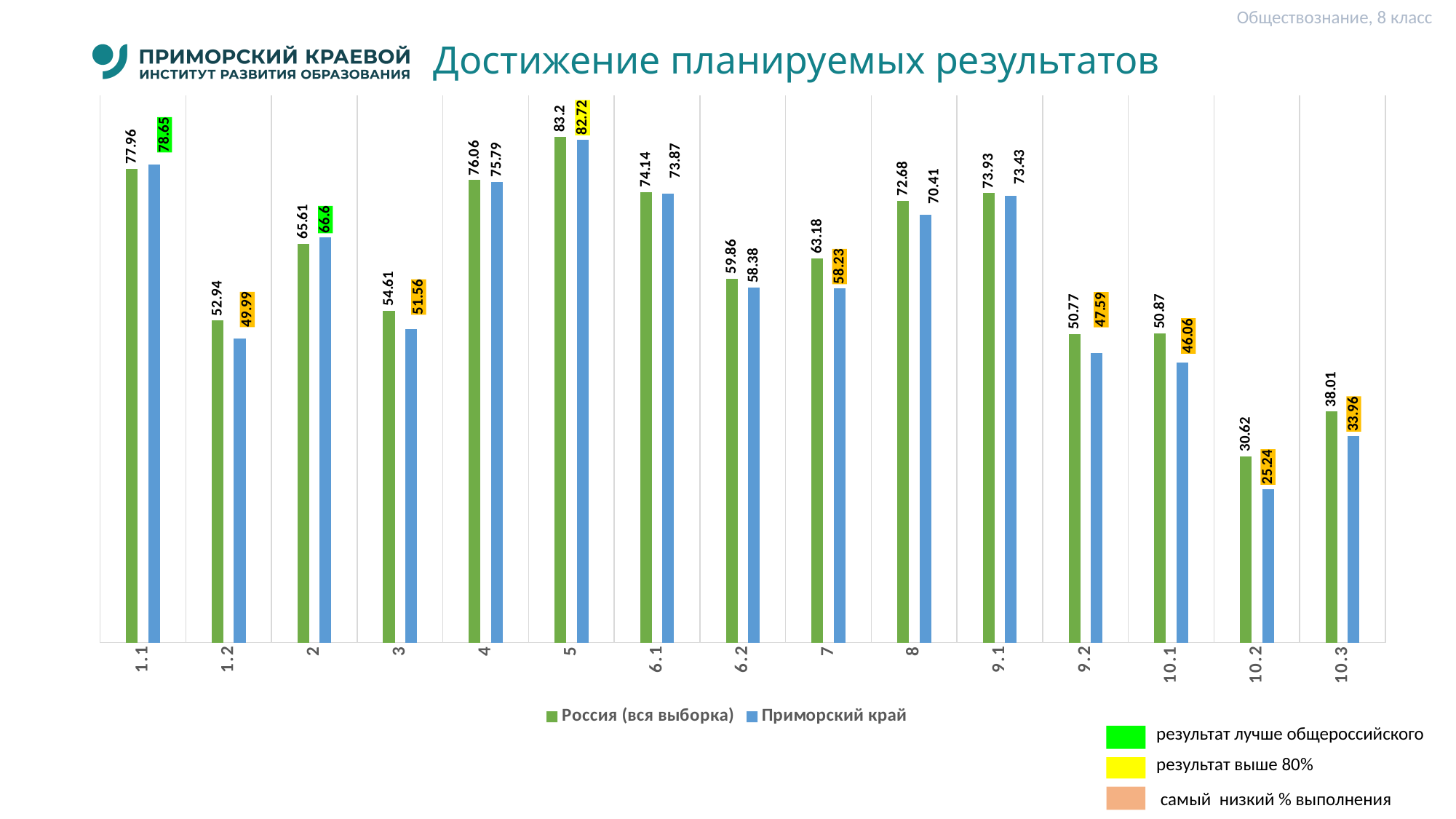
How many task categories are shown on the x axis? 15 Which task has the lowest value for Приморский край? 10.2 Which task has the highest value for Россия (вся выборка)? 5 What kind of chart is shown on the slide? bar chart For task 9.2, which series has the larger value: Россия (вся выборка) or Приморский край? Россия (вся выборка) What is the value for Приморский край for task 7? 58.23 What is the value for Россия (вся выборка) for task 10.2? 30.62 How many series does the legend list? 2 What is the value for Приморский край for task 5? 82.72 What is the difference between Россия (вся выборка) and Приморский край for task 10.2? 5.38 For task 2, which series has the larger value: Россия (вся выборка) or Приморский край? Приморский край What is the difference between Россия (вся выборка) and Приморский край for task 10.1? 4.81